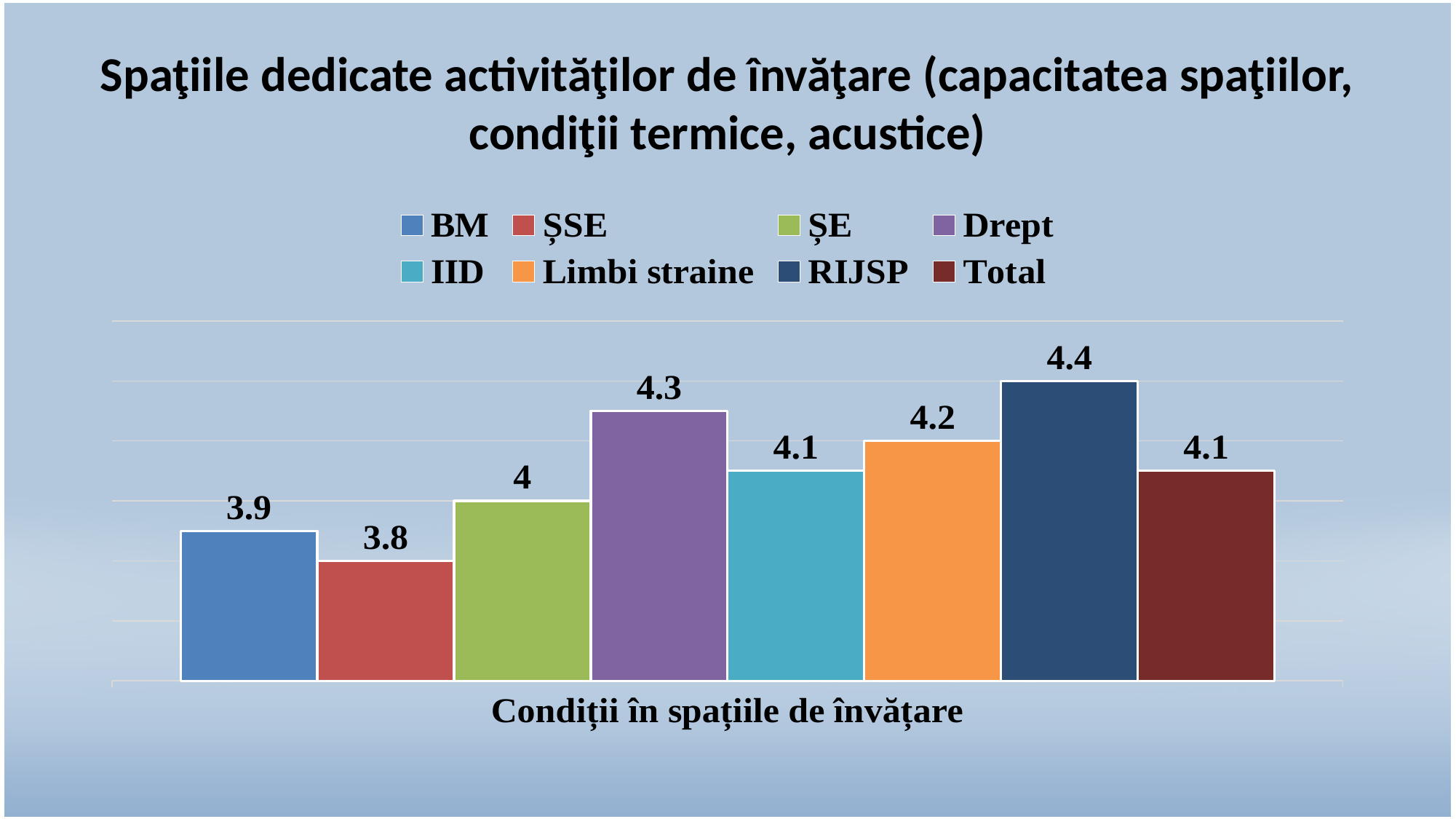
Which is larger, the value for Limbi straine or the value for IID? Limbi straine What is the difference between the values for RIJSP and ȘSE? 0.6 Which series has the highest value? RIJSP How many series does the legend list? 8 Which series has the lowest value? ȘSE What is the value for Total? 4.1 What is the value for RIJSP? 4.4 What is the value for Drept? 4.3 What kind of chart is shown on the slide? bar chart What is the label shown below the bars on the x axis? Condiții în spațiile de învățare What is the difference between the values for Drept and BM? 0.4 What is the value for ȘSE? 3.8